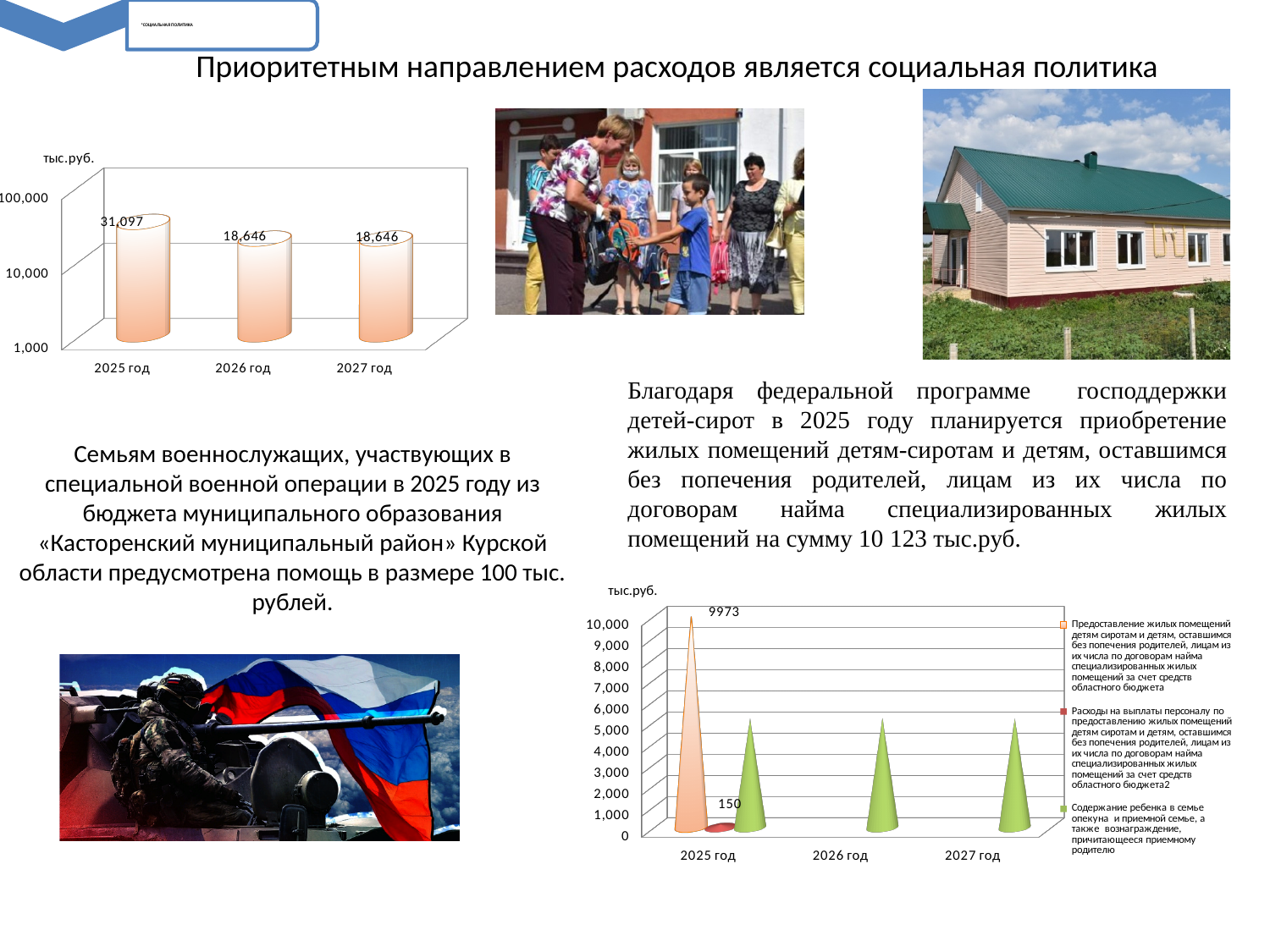
In the bottom-right chart, is the value of the green cone for 2026 год greater or less than 8,000? less In the top-left chart, do the values rise or fall from 2025 год to 2026 год? fall In the top-left chart, how many years are shown on the x axis? 3 In the bottom-right chart, what is the labelled value of the tallest cone for 2025 год? 9973 In the top-left chart, what is the difference between the values for 2025 год and 2027 год? 12,451 In the top-left chart, what is the value for 2026 год? 18,646 In the top-left chart, what unit is shown above the vertical axis? тыс.руб. In the top-left chart, what is the value for 2025 год? 31,097 In the bottom-right chart, how many series does the legend list? 3 In the bottom-right chart, what is the smallest labelled value for 2025 год? 150 In the top-left chart, which year has the highest value? 2025 год In the bottom-right chart, what is the difference between the two labelled values for 2025 год (9973 and 150)? 9823